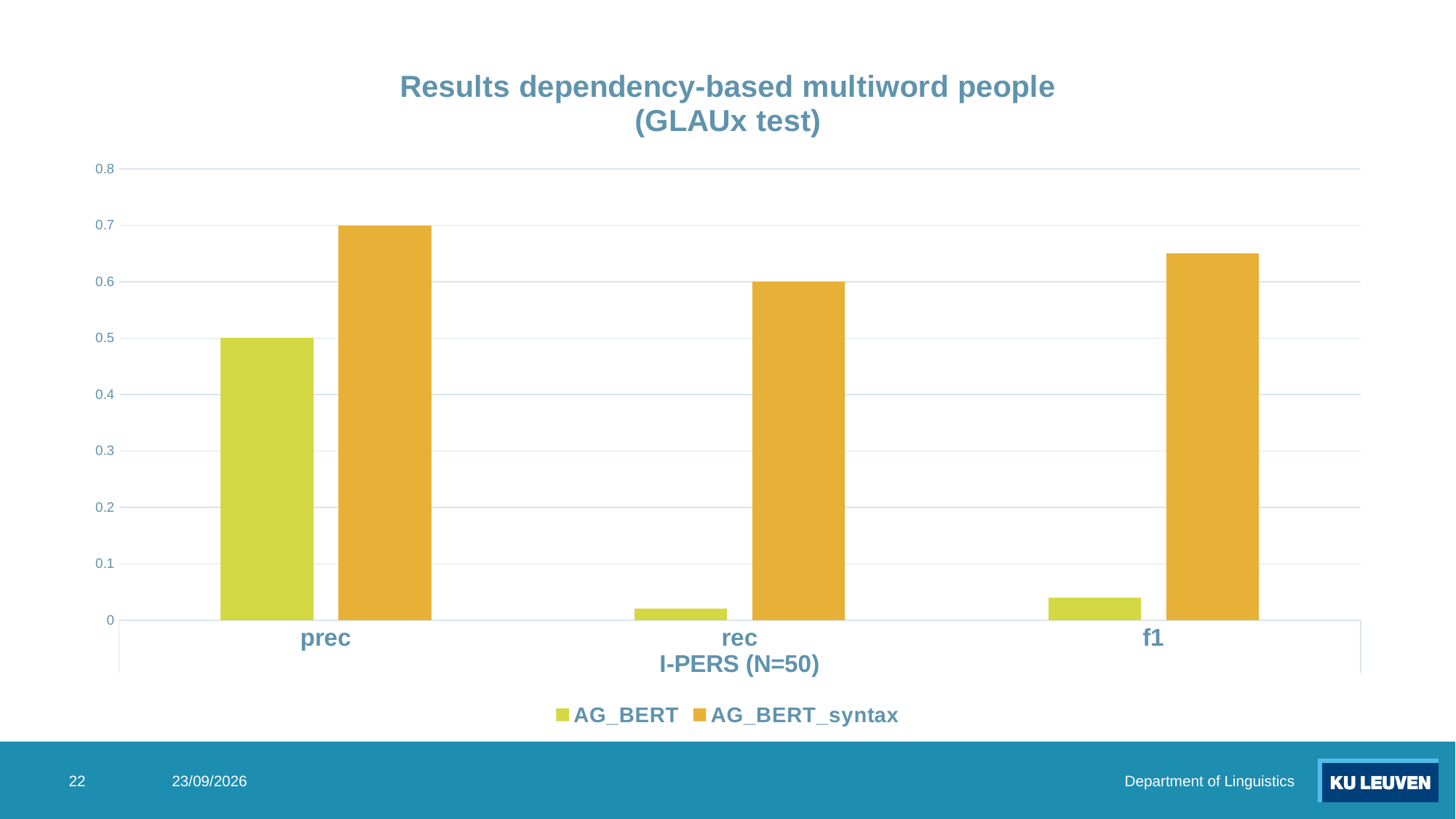
What is the value of AG_BERT_syntax for rec? 0.6 Is the value of AG_BERT for f1 greater or less than 0.1? less Which category has the highest value for AG_BERT_syntax? prec What is the difference between AG_BERT_syntax and AG_BERT for prec? 0.2 How many categories are shown on the x axis? 3 What type of chart is shown on the slide? bar chart How many series does the legend list? 2 Which category has the lowest value for AG_BERT? rec What is the value of AG_BERT_syntax for prec? 0.7 Which series is larger for rec, AG_BERT or AG_BERT_syntax? AG_BERT_syntax What is the value of AG_BERT for prec? 0.5 Is the value of AG_BERT_syntax for f1 greater or less than 0.6? greater